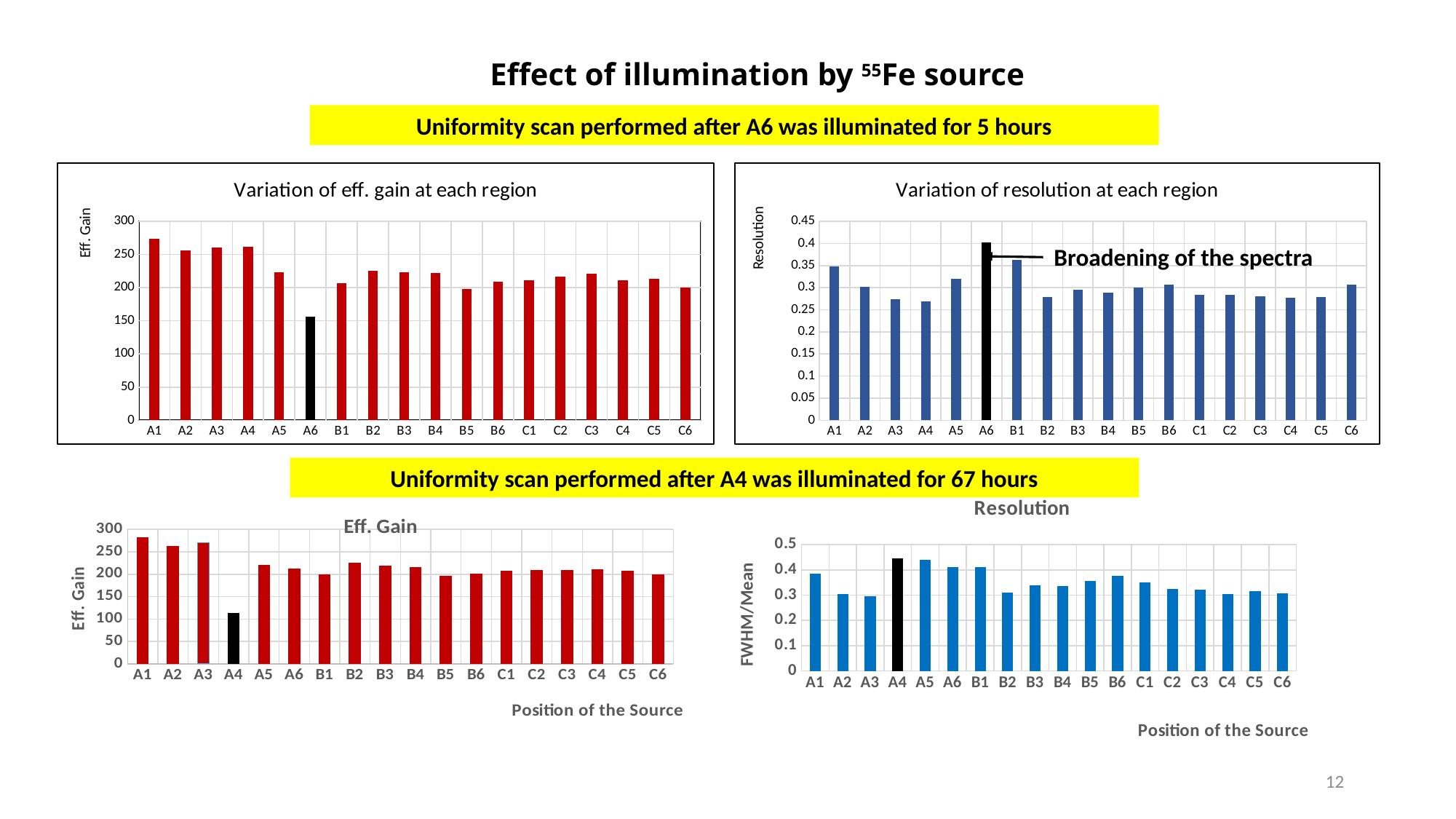
In the top-left chart titled 'Variation of eff. gain at each region', which region has the lowest effective gain? A6 What text annotation points to the A6 bar in the top-right chart titled 'Variation of resolution at each region'? Broadening of the spectra In the top-right chart titled 'Variation of resolution at each region', is the value for A6 greater or less than 0.35? greater In the bottom-right chart titled 'Resolution', is the value for A1 greater or less than 0.3? greater In the top-left chart titled 'Variation of eff. gain at each region', is the value for A1 greater or less than 250? greater How many positions are plotted on the x axis of the bottom-left chart titled 'Eff. Gain'? 18 In the top-right chart titled 'Variation of resolution at each region', which is larger, the value for A6 or the value for A4? A6 In the top-left chart titled 'Variation of eff. gain at each region', which region has the highest effective gain? A1 In the bottom-left chart titled 'Eff. Gain', which position of the source has the lowest effective gain? A4 In the top-right chart titled 'Variation of resolution at each region', which region has the highest resolution value? A6